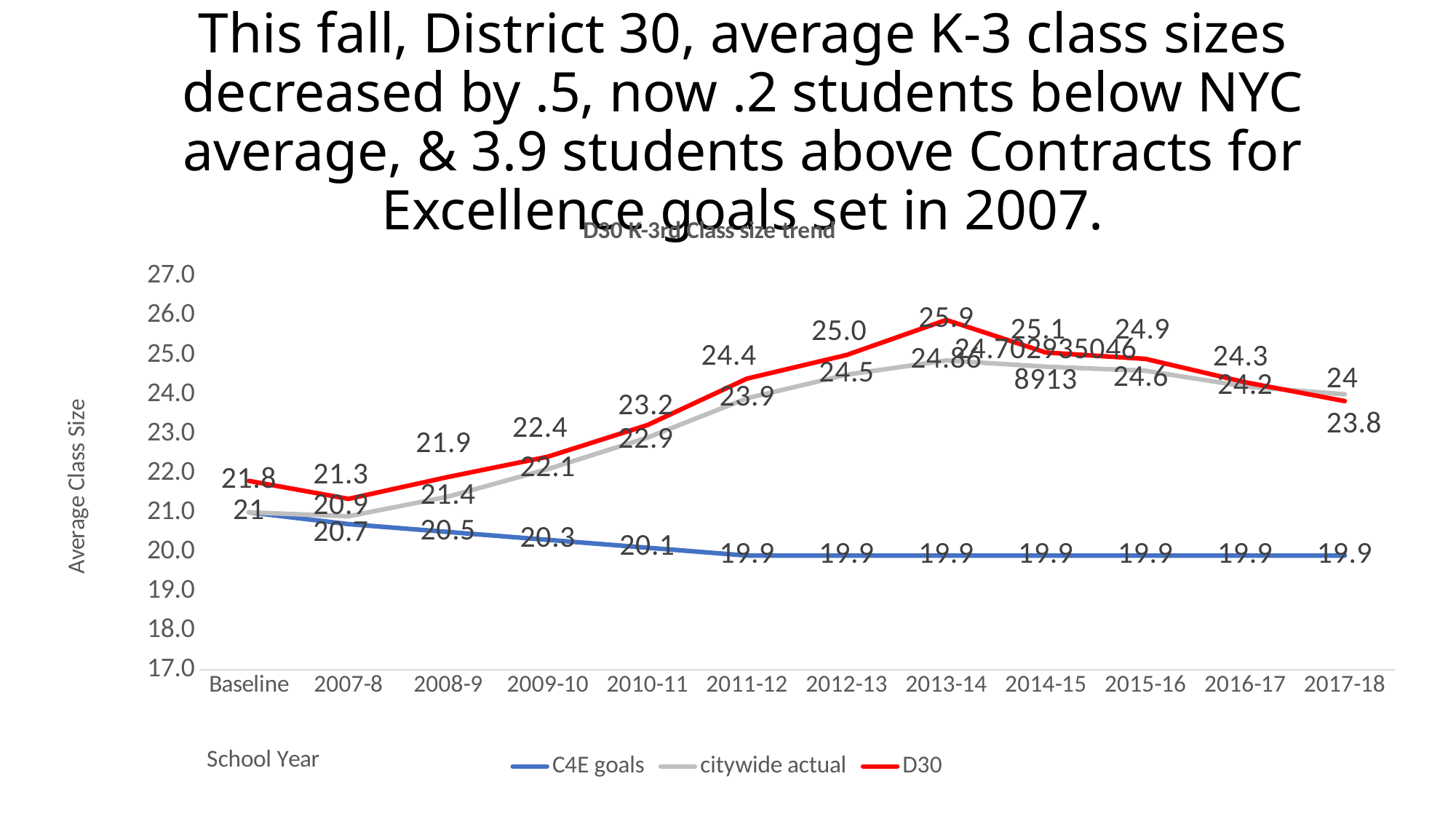
Do the C4E goals values rise or fall from Baseline to 2017-18? fall What kind of chart is shown on the slide? line chart In 2011-12, which is larger: the D30 value or the citywide actual value? D30 What is the label on the vertical axis? Average Class Size What is the citywide actual value for 2012-13? 24.5 How many school-year categories are shown on the x axis? 12 How many series does the legend list? 3 What is the C4E goals value for 2009-10? 20.3 In which school year is the D30 value lowest? 2007-8 What is the difference between the D30 values for 2016-17 and 2017-18? 0.5 What is the D30 value for 2013-14? 25.9 In which school year is the D30 value highest? 2013-14